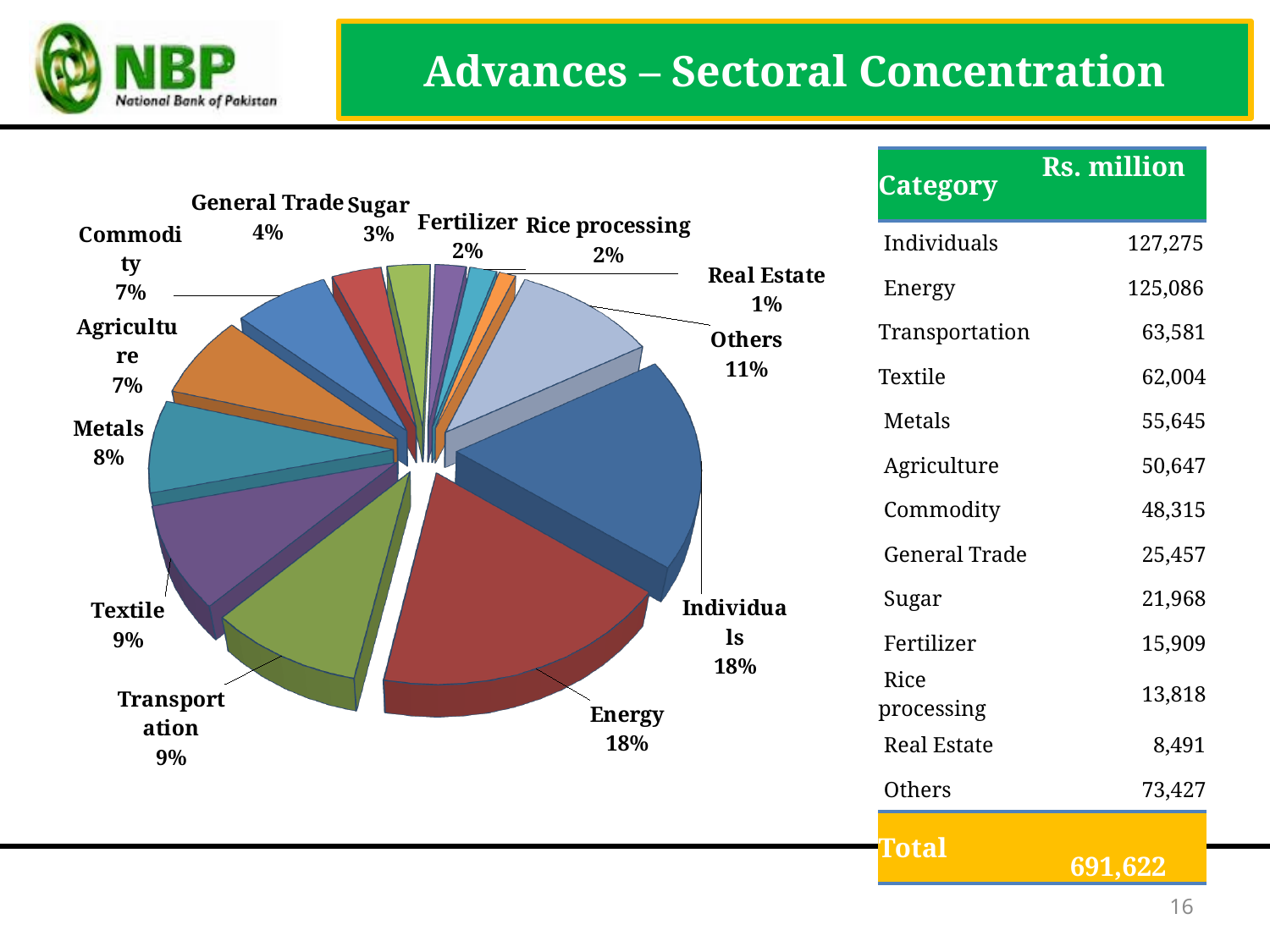
What kind of chart is shown on the slide? pie chart What percentage is shown for Others in the pie chart? 11% What percentage is shown for Metals in the pie chart? 8% What percentage is shown for Textile in the pie chart? 9% Which category has the smallest slice of the pie? Real Estate How many slices does the pie chart have? 13 What percentage is shown for Sugar in the pie chart? 3% What share of the pie does Individuals account for? 18% Which slice is larger, Others or Metals? Others What percentage is shown for Agriculture in the pie chart? 7% What is the difference in percentage points between the Others slice and the Metals slice? 3 What is the title of the slide containing the pie chart? Advances – Sectoral Concentration